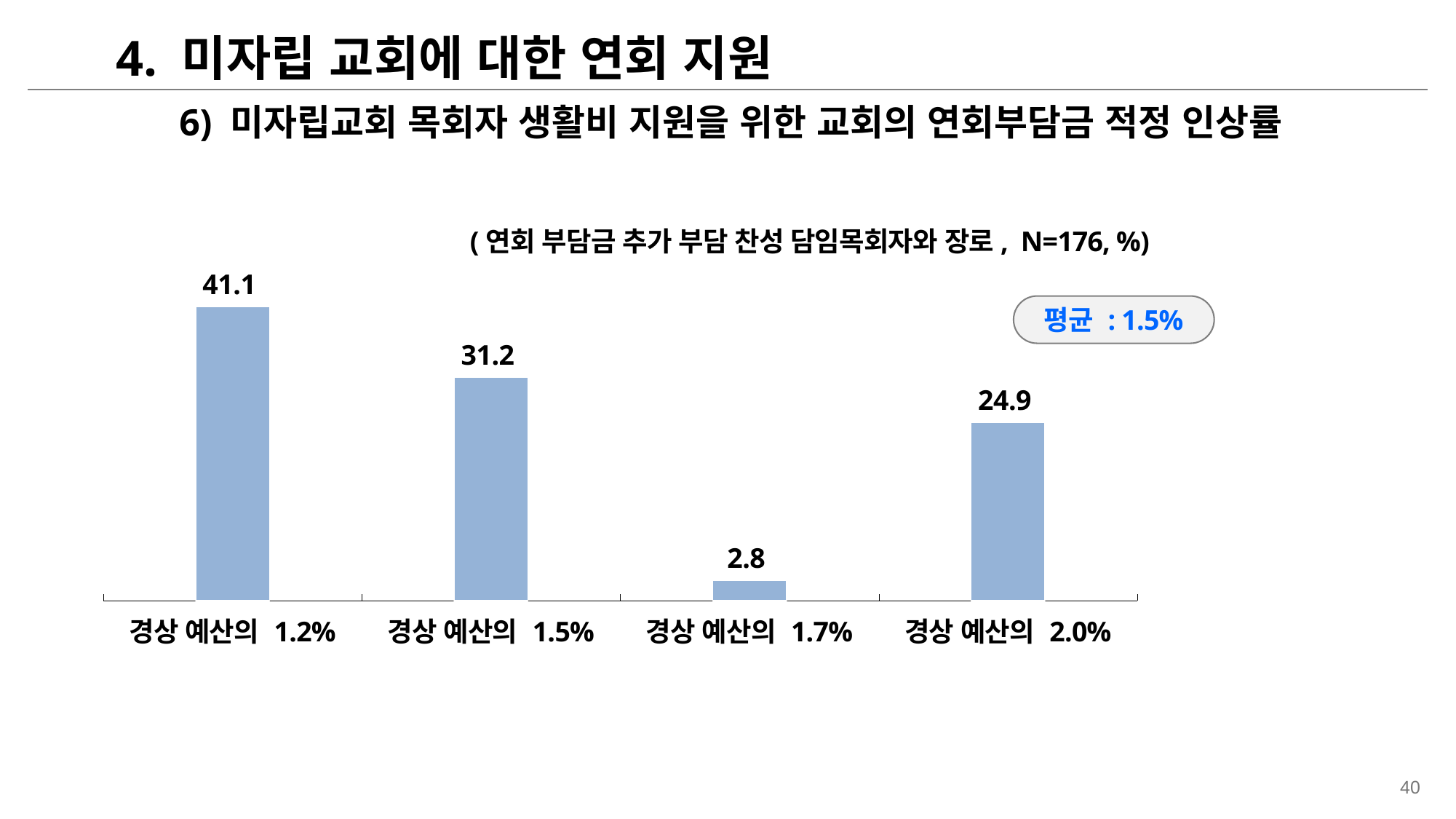
What kind of chart is shown on the slide? Bar chart Which category has the highest value? 경상 예산의 1.2% Which category has the lowest value? 경상 예산의 1.7% What is the value for 경상 예산의 1.7%? 2.8 What is the value for 경상 예산의 1.5%? 31.2 Which is larger, the value for 경상 예산의 1.5% or the value for 경상 예산의 2.0%? 경상 예산의 1.5% What is the difference between the values for 경상 예산의 1.2% and 경상 예산의 1.5%? 9.9 What is the value for 경상 예산의 2.0%? 24.9 How many categories are shown in the chart? 4 What is the value for 경상 예산의 1.2%? 41.1 What is the difference between the values for 경상 예산의 1.5% and 경상 예산의 2.0%? 6.3 What average (평균) value is shown in the box on the chart? 1.5%